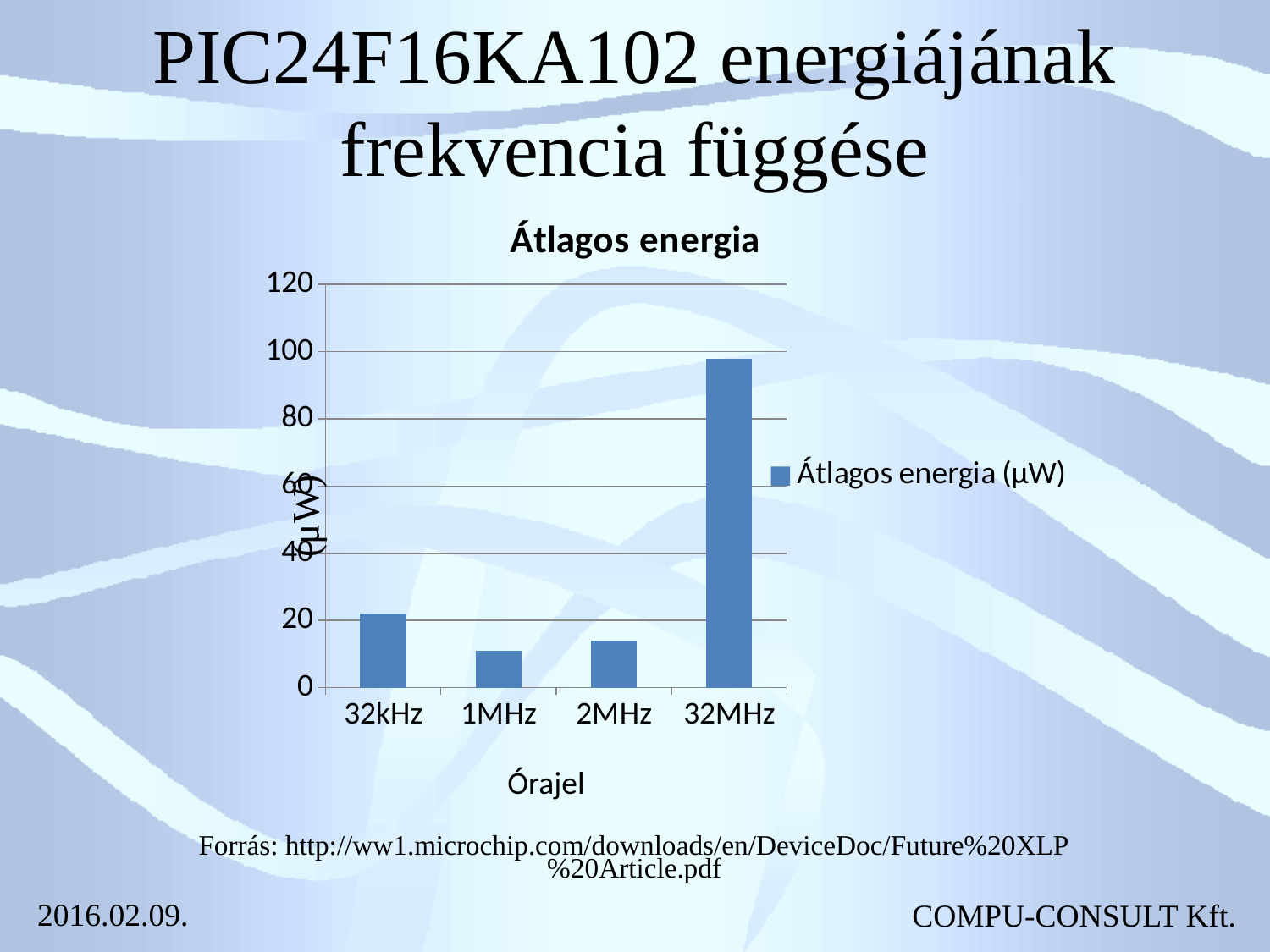
Is the value for 32MHz greater or less than 80? greater Which has a larger average energy, 32kHz or 1MHz? 32kHz How many series does the chart's legend list? 1 Which has a larger average energy, 32MHz or 32kHz? 32MHz Is the value for 1MHz greater or less than 20? less What is the legend entry of the chart? Átlagos energia (μW) What kind of chart is shown on the slide? bar chart Which clock frequency has the highest average energy? 32MHz How many categories are shown on the x axis of the chart? 4 What is the title of the chart? Átlagos energia Which clock frequency has the lowest average energy? 1MHz Is the value for 2MHz greater or less than 20? less